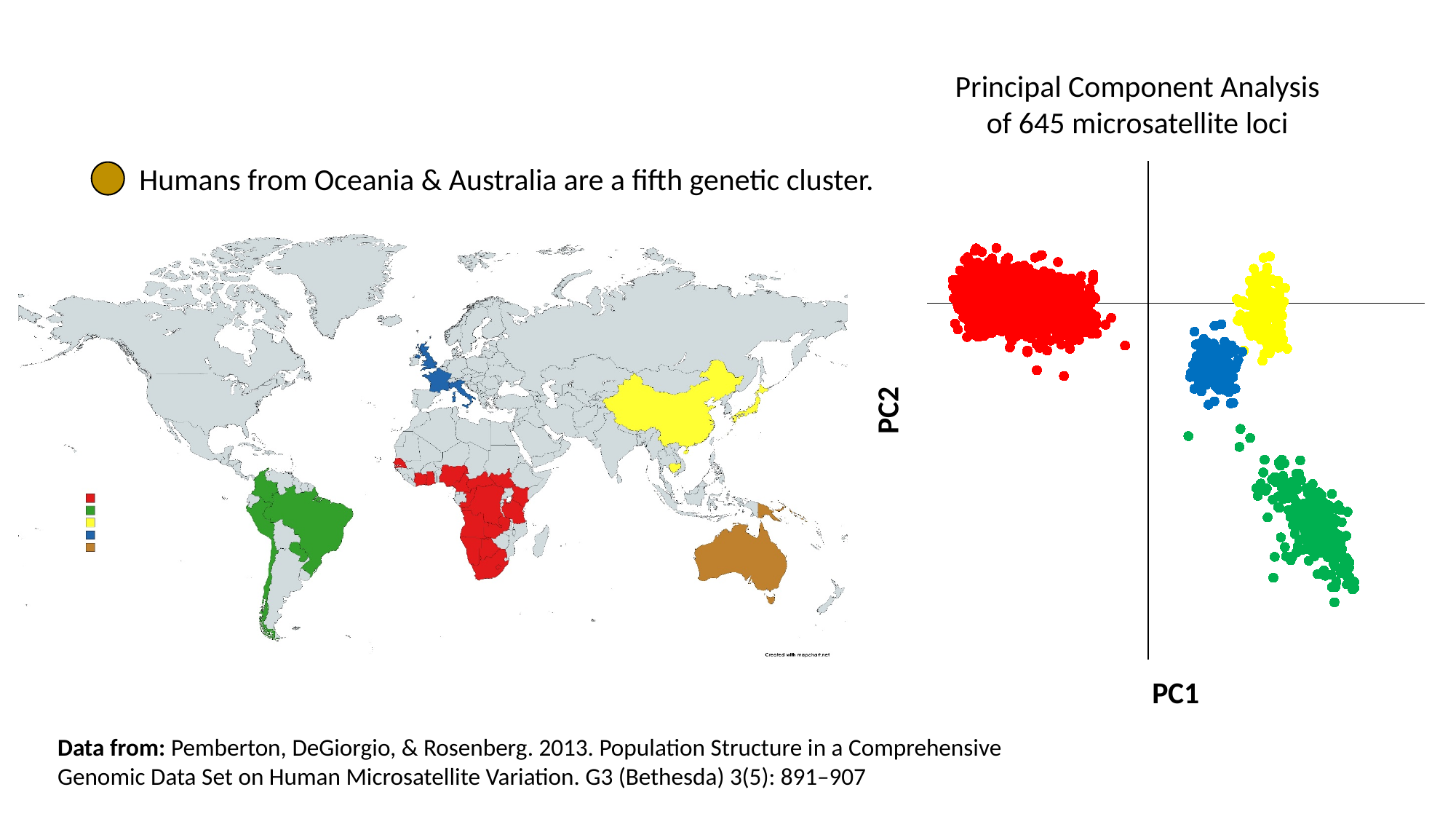
In the scatter plot, which cluster is higher on PC2: the blue cluster or the green cluster? blue Which coloured cluster in the scatter plot lies lowest on the PC2 axis? green In the scatter plot, which cluster is higher on PC2: the yellow cluster or the blue cluster? yellow How many differently coloured clusters of points are plotted in the scatter plot? 4 What kind of chart is shown on the right side of the slide? scatter plot What is the label of the vertical axis of the scatter plot? PC2 In the scatter plot, is the red cluster to the left or to the right of the vertical PC2 axis line? left Which coloured cluster in the scatter plot lies furthest right on the PC1 axis? green What is the title of the scatter plot on the right? Principal Component Analysis of 645 microsatellite loci Which coloured cluster in the scatter plot lies furthest left on the PC1 axis? red What is the label of the horizontal axis of the scatter plot? PC1